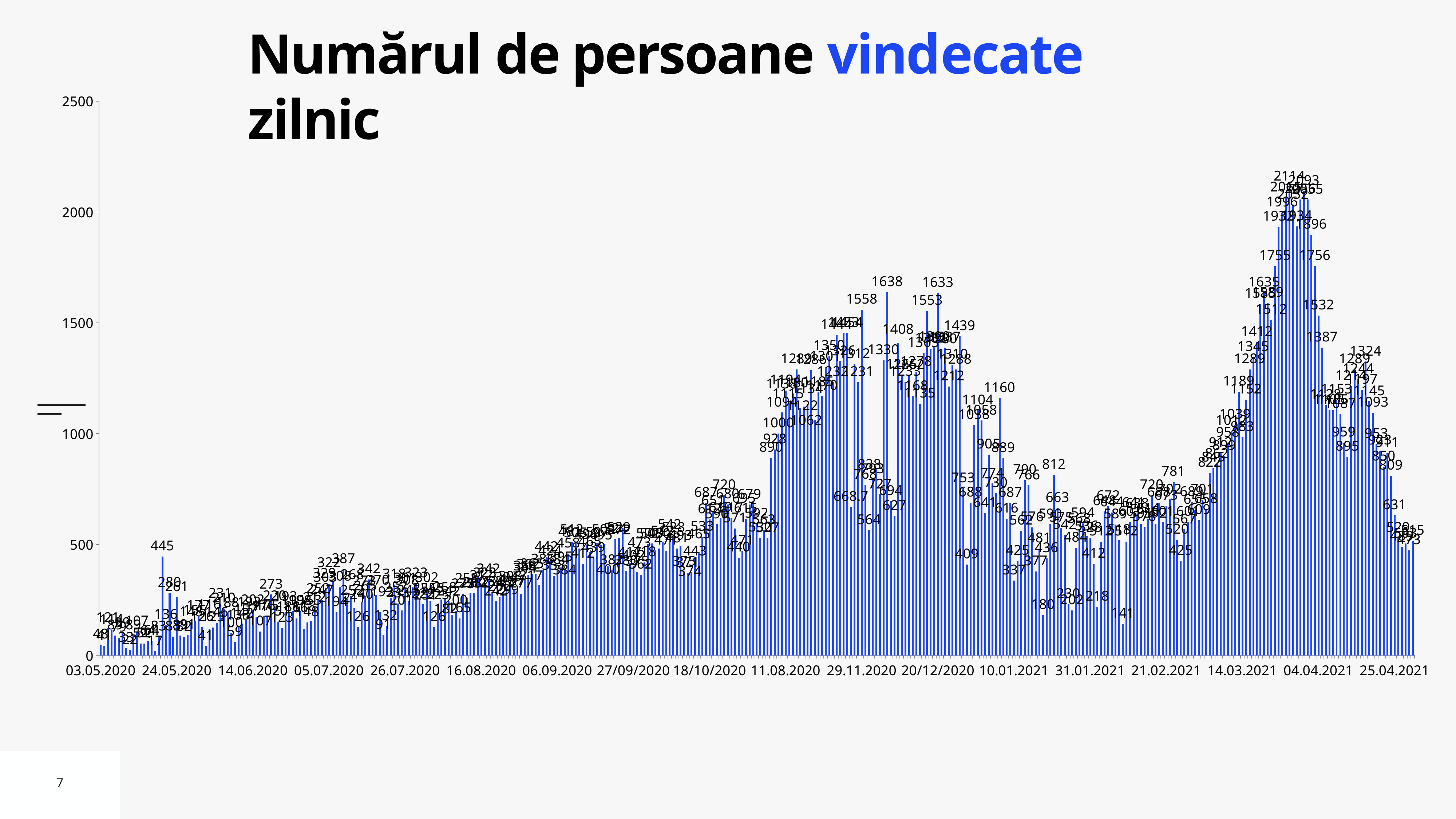
Do the values rise or fall between 04.04.2021 and 25.04.2021? fall What is the first date label on the horizontal axis? 03.05.2020 What kind of chart is shown on the slide? bar chart What is the maximum value shown on the vertical axis? 2500 What is the title of the chart on the slide? Numărul de persoane vindecate zilnic Do the values rise or fall between 14.03.2021 and 04.04.2021? rise Is the bar labeled 445 near 24.05.2020 greater or less than 500? less Which is larger: the peak value near 04.04.2021 (2114) or the peak value near 29.11.2020 (1638)? 2114 What is the last date label on the horizontal axis? 25.04.2021 How many date labels are shown on the horizontal axis? 18 Is the tallest bar near 04.04.2021 greater or less than 2000? greater What is the highest value labeled on the chart? 2114